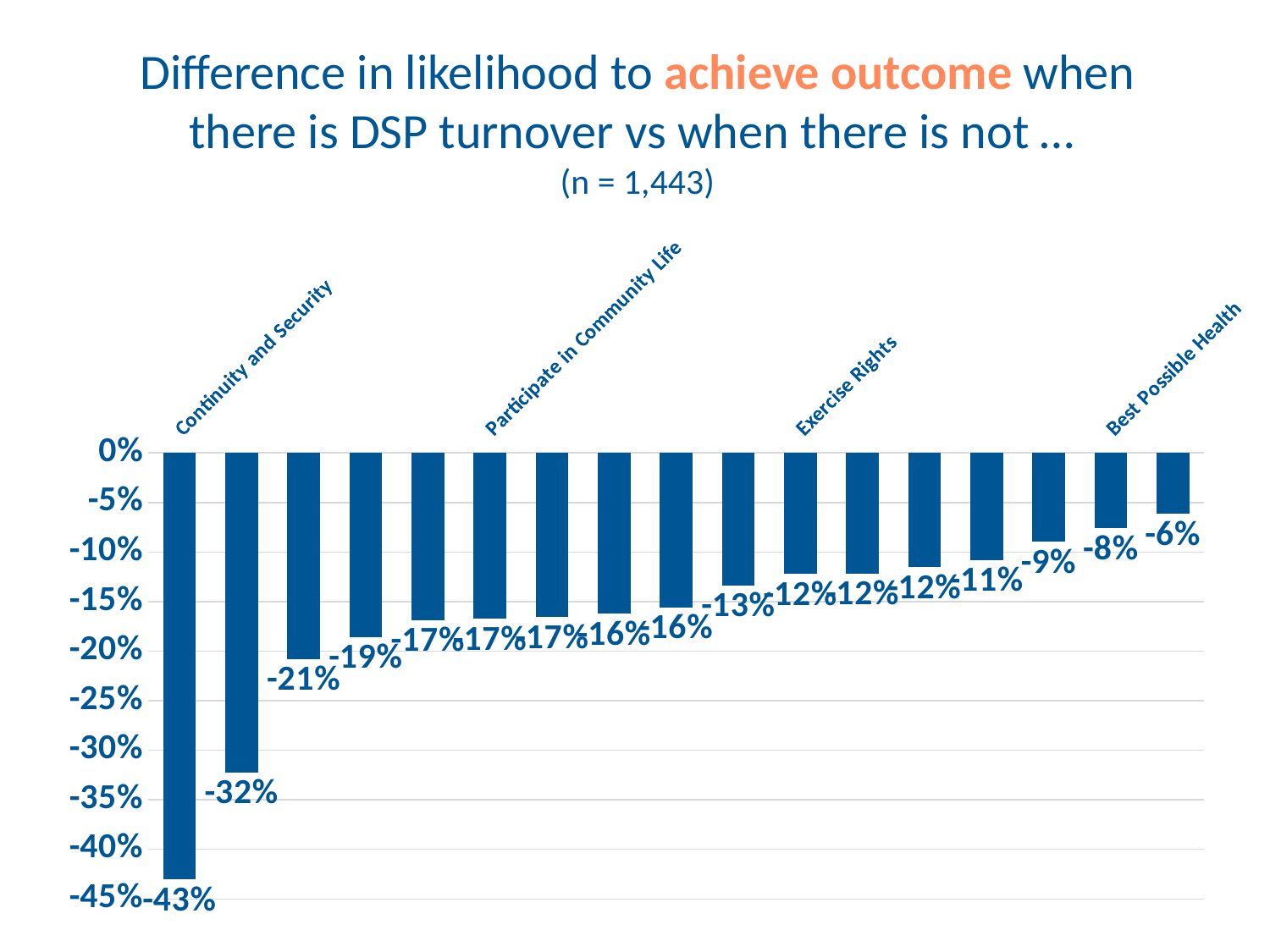
How many bars are plotted in the chart? 17 Do the bar values rise or fall moving from left to right along the x axis? Rise (become less negative) What is the value shown for Participate in Community Life? -17% Which category has the lowest (most negative) value in the chart? Continuity and Security What is the difference between the first bar (-43%) and the second bar (-32%)? 11 percentage points What is the highest (least negative) value shown in the chart? -6% Is the value for Best Possible Health greater or less than -10%? greater What is the value shown for Continuity and Security? -43% What is the value shown for Exercise Rights? -12% What sample size (n) is stated under the chart title? n = 1,443 What kind of chart is shown on the slide? Bar chart Which has the more negative value, Continuity and Security or Exercise Rights? Continuity and Security